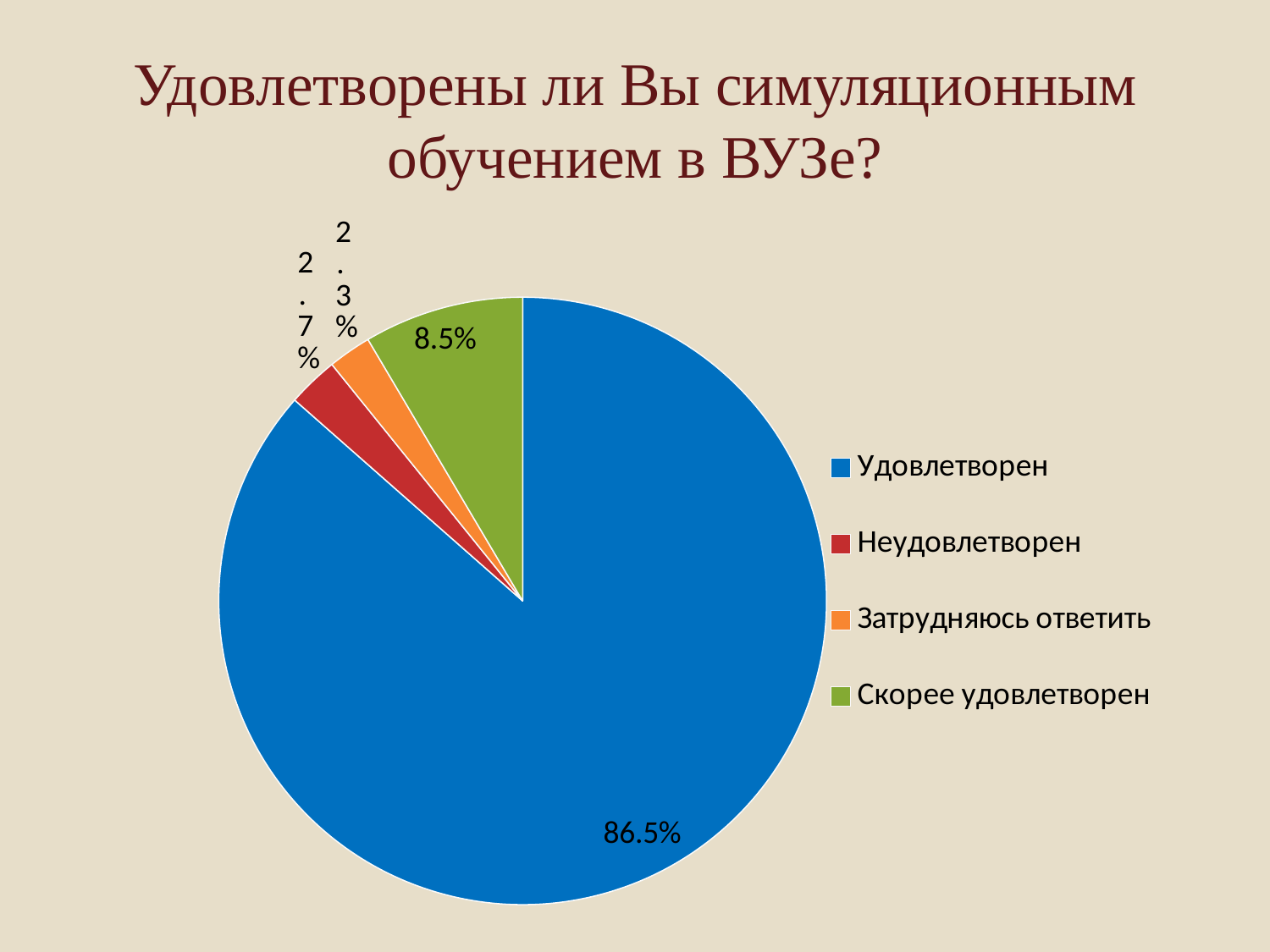
Which is larger, the value for Скорее удовлетворен or the value for Неудовлетворен? Скорее удовлетворен Which category has the largest share of the pie? Удовлетворен What is the value for Скорее удовлетворен? 8.5% What is the value for Удовлетворен? 86.5% What is the title of the chart? Удовлетворены ли Вы симуляционным обучением в ВУЗе? What colour is the slice for Скорее удовлетворен? green What kind of chart is shown on the slide? pie chart How many categories does the pie chart have? 4 Which category has the smallest share of the pie? Затрудняюсь ответить What is the value for Затрудняюсь ответить? 2.3% What is the difference between the values for Удовлетворен and Скорее удовлетворен? 78.0% What is the value for Неудовлетворен? 2.7%